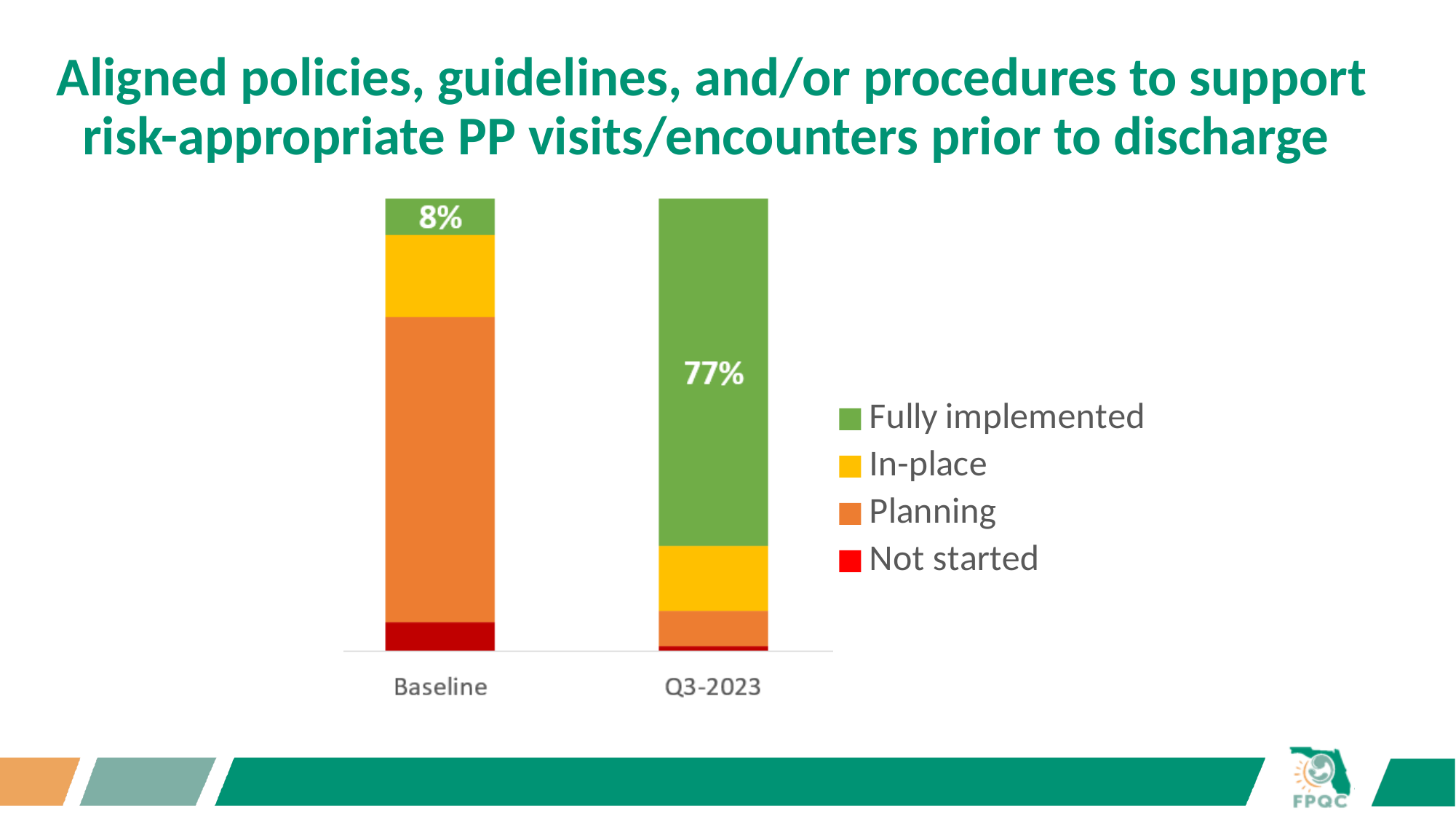
Which series makes up the largest portion of the Q3-2023 bar? Fully implemented Which series is shown in yellow in the legend? In-place By how many percentage points did the Fully implemented share increase from Baseline to Q3-2023? 69 Which category has the higher Fully implemented share, Baseline or Q3-2023? Q3-2023 Which colour represents the Not started series in the legend? Red What percentage of the Q3-2023 bar is Fully implemented? 77% What kind of chart is shown on the slide? Stacked bar chart What percentage of the Baseline bar is Fully implemented? 8% How many series does the legend list? 4 Does the Fully implemented share rise or fall from Baseline to Q3-2023? Rise Which series makes up the largest portion of the Baseline bar? Planning How many categories are shown on the x axis? 2